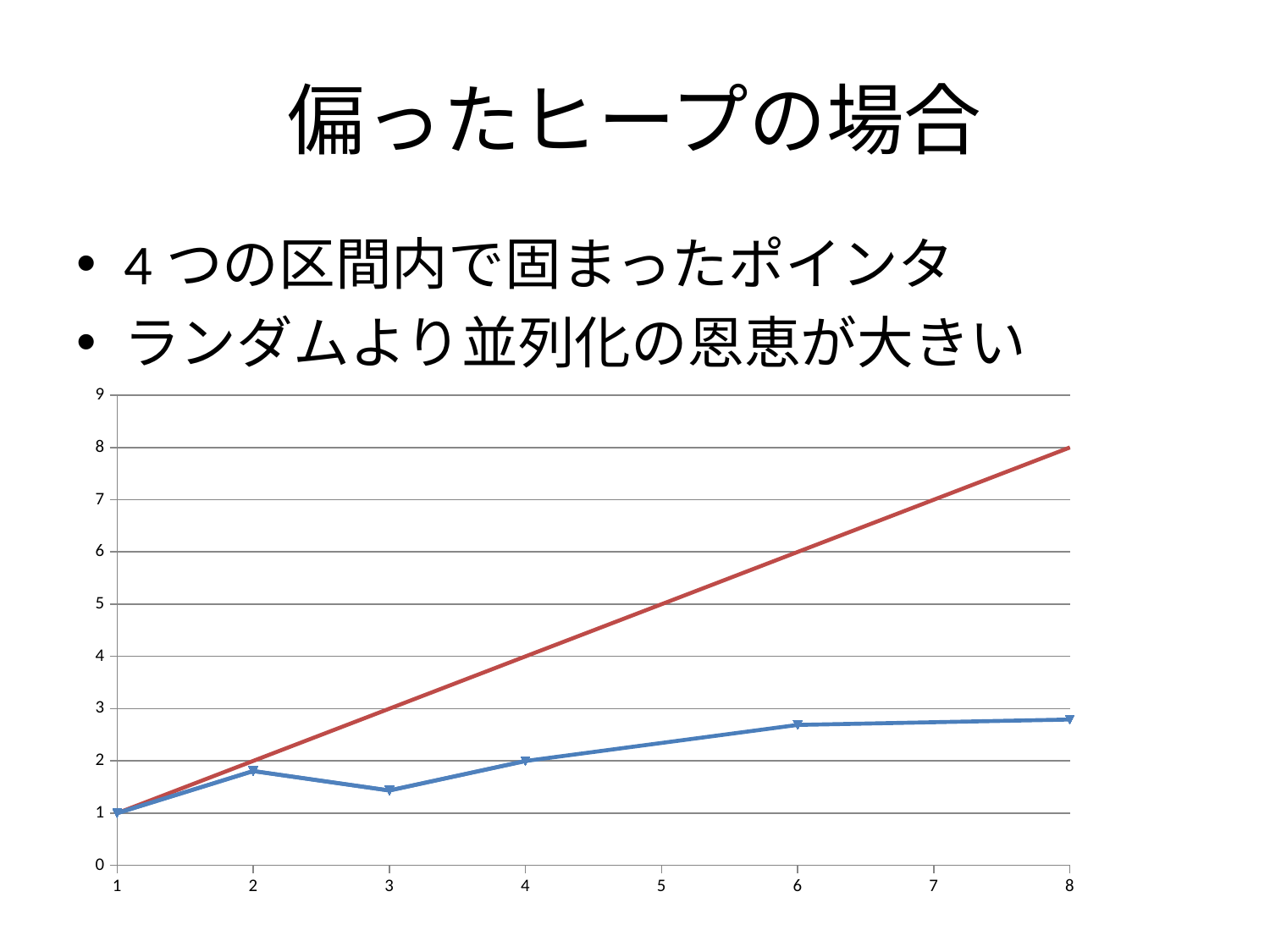
At which x value does the blue line reach its lowest value? 1 Does the red line rise or fall as x increases from 1 to 8? rises What is the value of the blue line at x = 4? 2 How many data points (markers) does the blue line have? 6 How many lines are plotted on the chart? 2 Is the value of the blue line at x = 8 greater or less than 3? less What kind of chart is shown on the slide? line chart What is the value of the blue line at x = 1? 1 What is the value of the red line at x = 8? 8 Is the value of the blue line at x = 6 greater or less than 2? greater At x = 8, which line has the larger value, the red line or the blue line? the red line What is the value of the red line at x = 4? 4